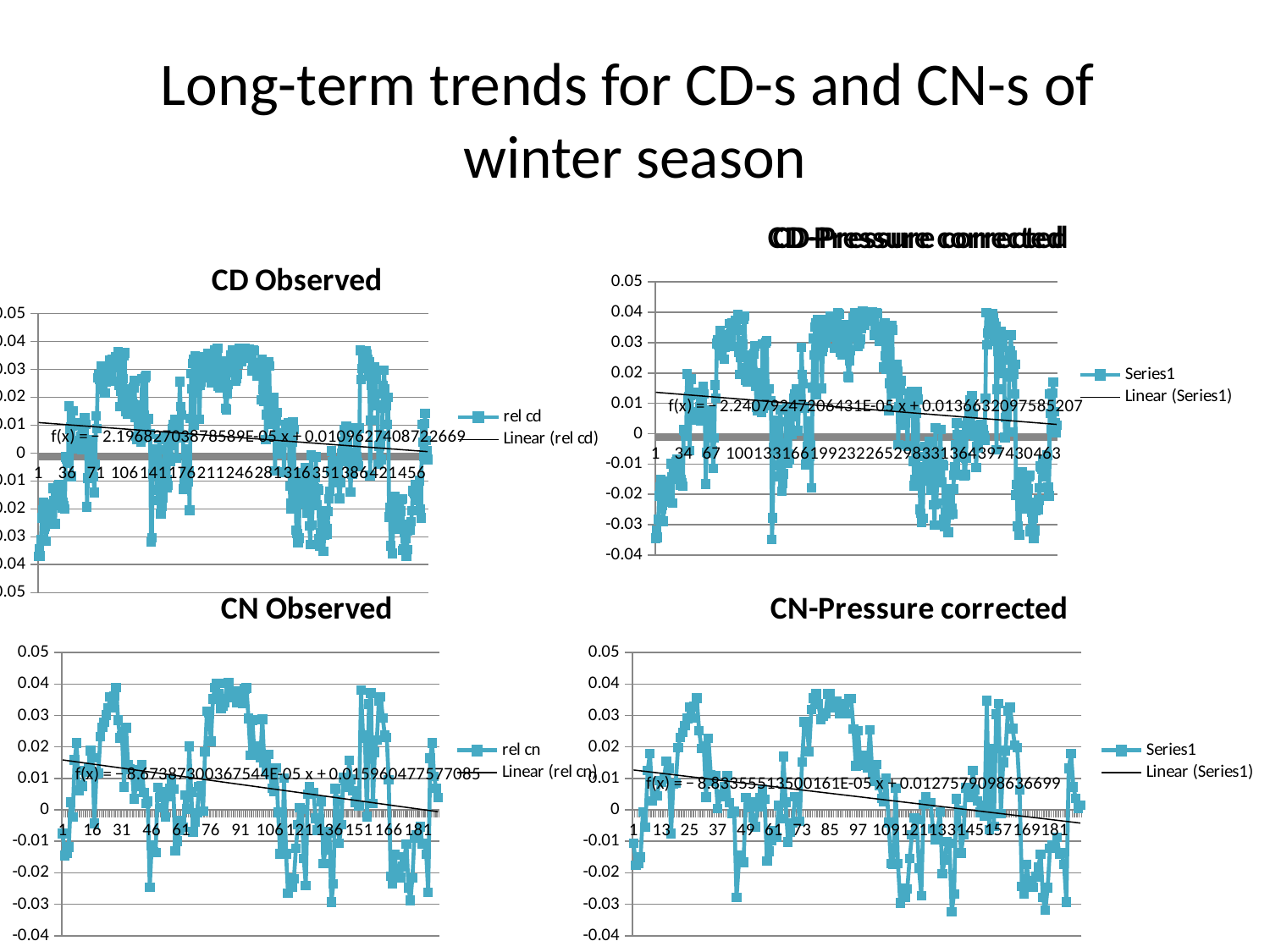
How many charts are on the slide? 4 What is the title of the chart in the bottom-right position of the slide? CN-Pressure corrected In the "CD-Pressure corrected" chart, how many entries does the legend list? 2 What kind of chart is the "CN-Pressure corrected" chart? line chart In the "CN Observed" chart, does the linear trendline rise or fall along the x axis? fall In the "CD-Pressure corrected" chart, does the linear trendline rise or fall along the x axis? fall What kind of chart is the "CD Observed" chart? line chart In the "CN Observed" chart, what are the legend entries? rel cn, Linear (rel cn) In the "CD Observed" chart, how many entries does the legend list? 2 In the "CN-Pressure corrected" chart, does the linear trendline rise or fall along the x axis? fall In the "CD Observed" chart, what are the legend entries? rel cd, Linear (rel cd)